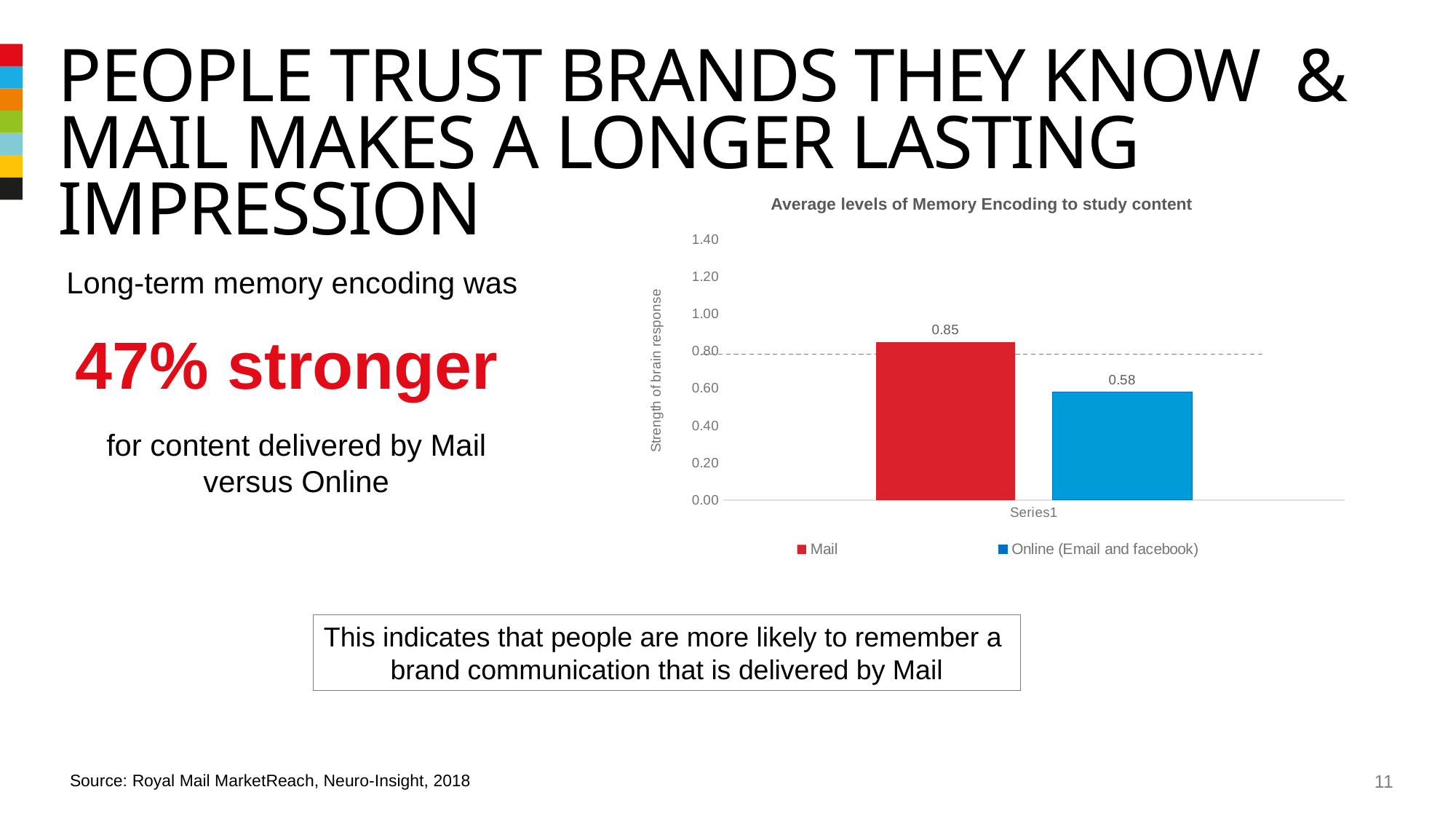
Which series has the lower value in the chart? Online (Email and facebook) What is the title of the chart? Average levels of Memory Encoding to study content Is the value for Mail greater or less than the value for Online (Email and facebook)? greater What is the difference between the Mail value and the Online (Email and facebook) value? 0.27 Is the value for Online (Email and facebook) greater or less than 0.80? less What is the value for Online (Email and facebook) in the chart? 0.58 How many series does the legend list? 2 What is the label on the vertical axis of the chart? Strength of brain response What kind of chart is shown on the slide? Bar chart What is the value for Mail in the chart? 0.85 Which series has the higher value, Mail or Online (Email and facebook)? Mail Is the value for Mail greater or less than 0.80? greater